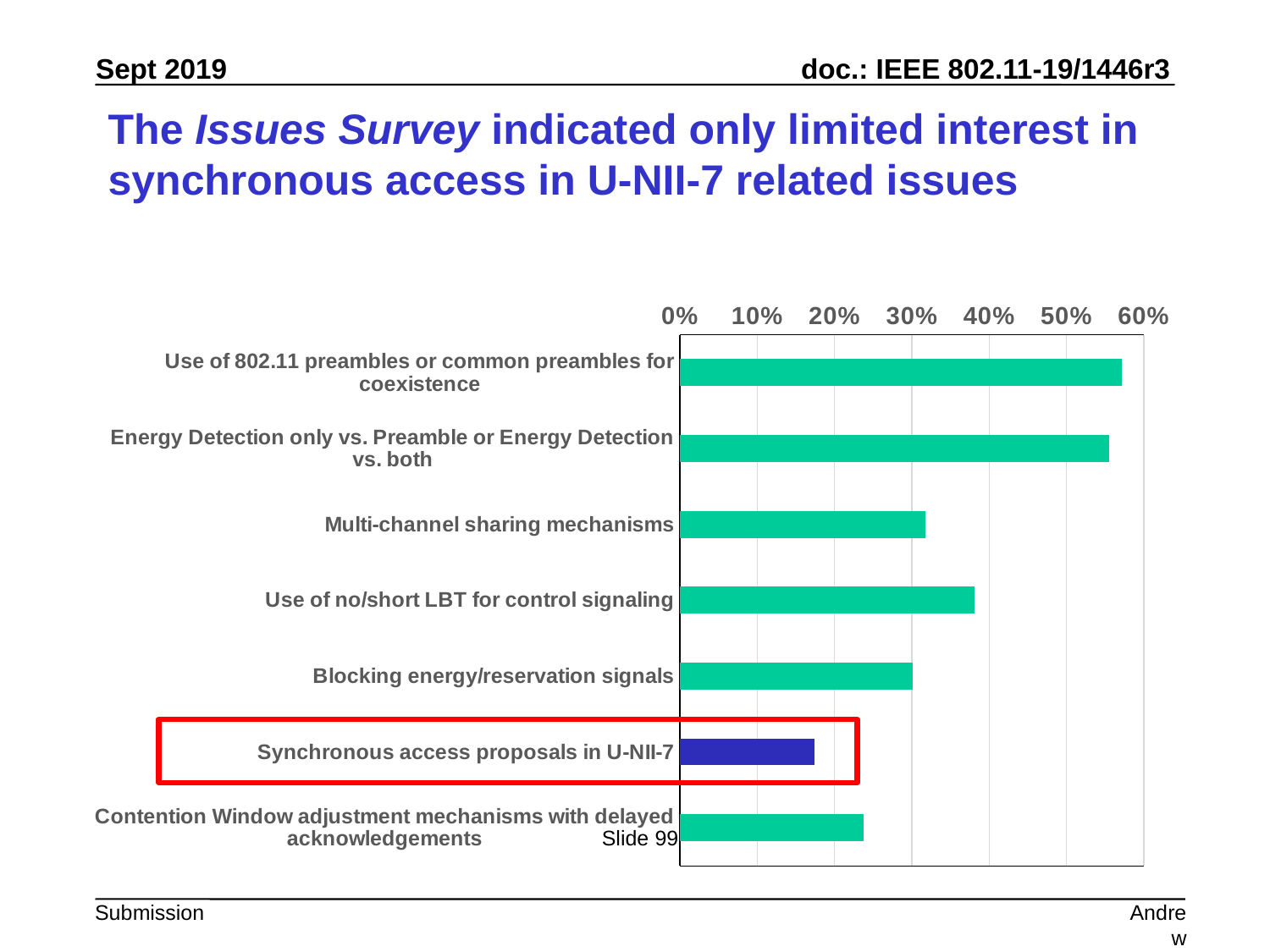
Which category has the lowest value in the chart? Synchronous access proposals in U-NII-7 Is the value for Use of no/short LBT for control signaling greater or less than 40%? less What is the highest tick value shown on the percentage axis? 60% Which is larger: the value for Contention Window adjustment mechanisms with delayed acknowledgements or the value for Synchronous access proposals in U-NII-7? Contention Window adjustment mechanisms with delayed acknowledgements What kind of chart is shown on the slide? bar chart How many categories (bars) does the chart show? 7 Is the value for Contention Window adjustment mechanisms with delayed acknowledgements greater or less than 20%? greater Is the value for Energy Detection only vs. Preamble or Energy Detection vs. both greater or less than 50%? greater Which category's bar is drawn in a different colour (dark blue) and outlined with a red box? Synchronous access proposals in U-NII-7 Which is larger: the value for Use of no/short LBT for control signaling or the value for Multi-channel sharing mechanisms? Use of no/short LBT for control signaling